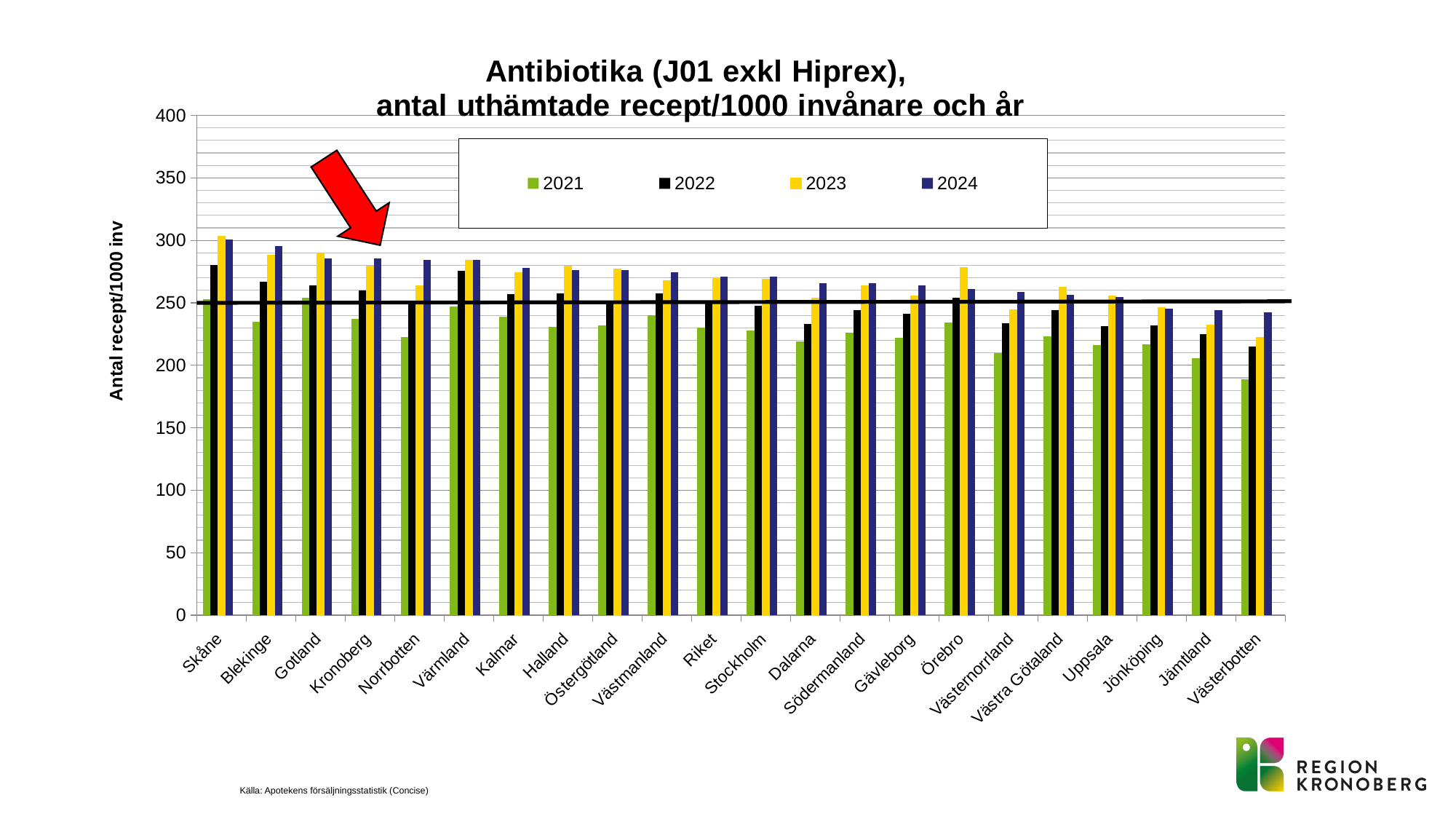
Which region has the highest 2023 value? Skåne Is the 2022 value for Skåne greater or less than 250? greater What is the title of the y axis? Antal recept/1000 inv How many regions (categories) are shown on the x axis? 22 Is the 2024 value for Blekinge greater or less than 300? less Is the 2021 value for Kronoberg greater or less than 250? less What kind of chart is shown on the slide? bar chart Which region has the lowest 2021 value? Västerbotten Which is larger, the 2024 value for Skåne or the 2024 value for Västerbotten? Skåne How many series does the legend list? 4 For Blekinge, which is larger, the 2021 value or the 2024 value? 2024